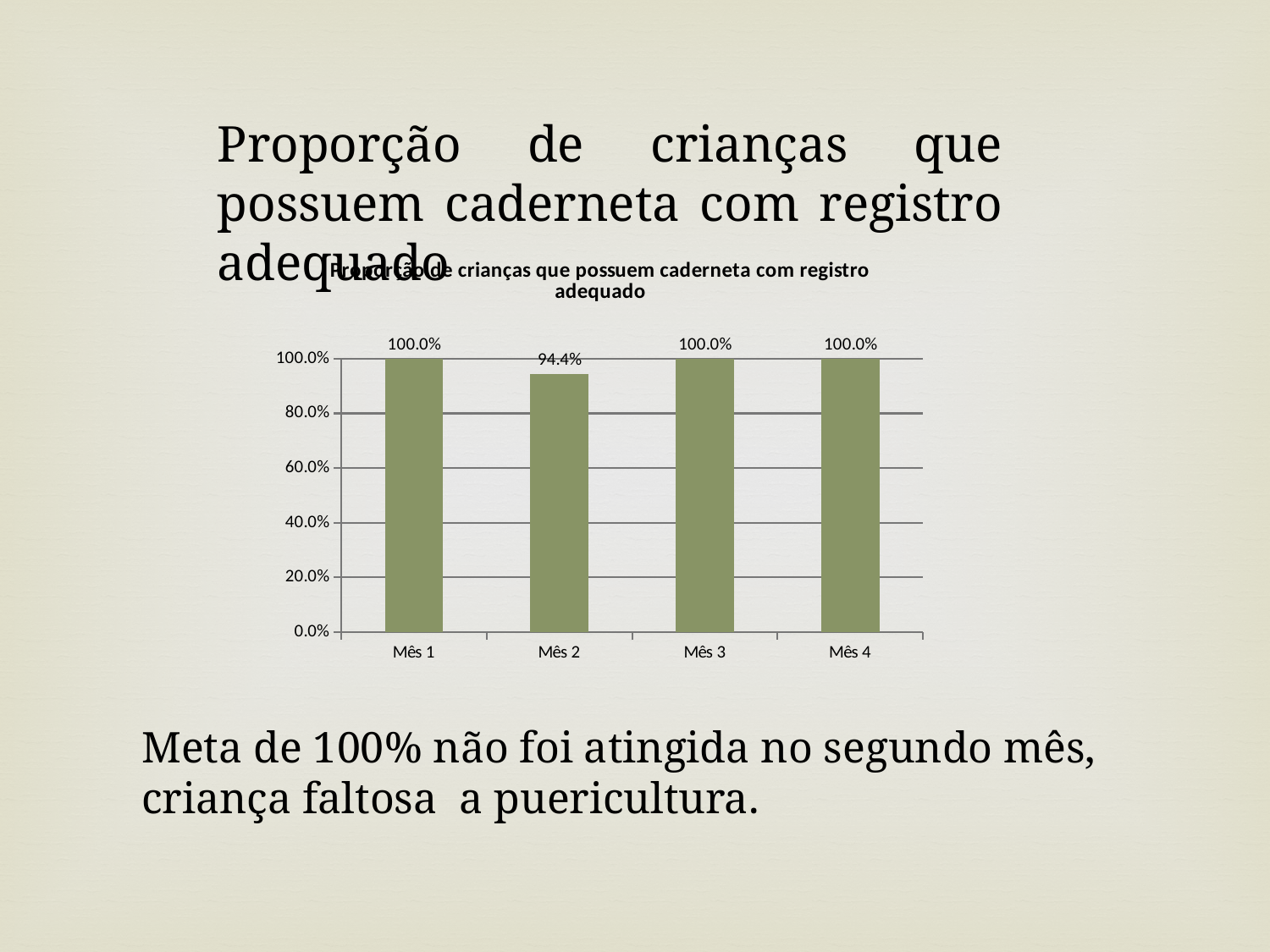
Which is larger, the value for Mês 2 or the value for Mês 3? Mês 3 What is the title of the chart? Proporção de crianças que possuem caderneta com registro adequado What kind of chart is shown on the slide? bar chart What is the value for Mês 1? 100.0% Which month has the lowest value? Mês 2 How many months are shown on the x axis? 4 What is the difference between the values for Mês 1 and Mês 2? 5.6% Is the value for Mês 2 greater or less than 80.0%? greater What is the value for Mês 2? 94.4% What is the highest value shown on the y axis? 100.0% What is the value for Mês 4? 100.0% How many months reach 100.0%? 3